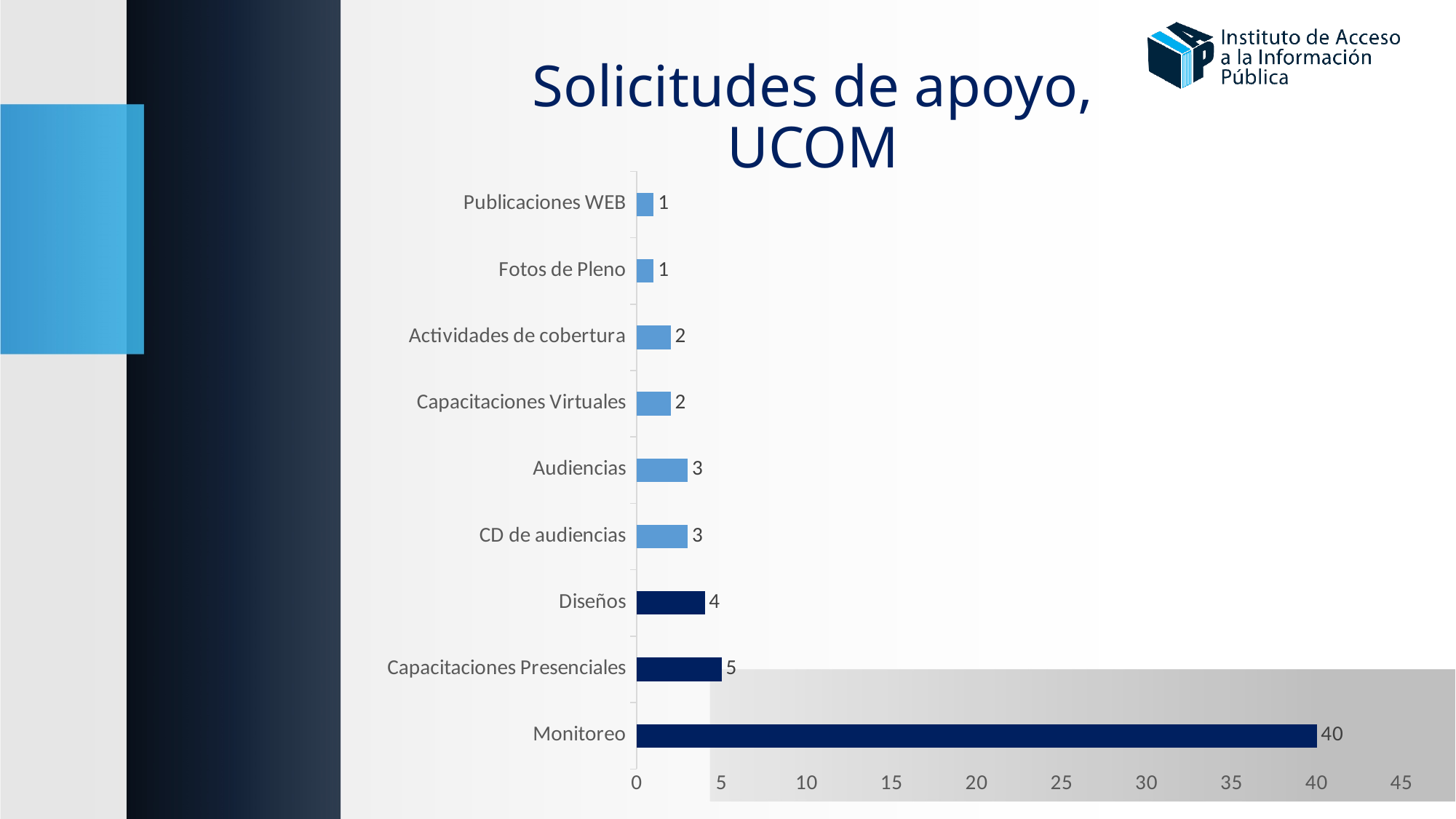
What is the difference between the values for Monitoreo and Capacitaciones Presenciales? 35 What is the highest value shown on the horizontal axis? 45 What kind of chart is shown on the slide? Bar chart What is the value for Monitoreo? 40 What is the value for Actividades de cobertura? 2 What is the title of the chart? Solicitudes de apoyo, UCOM Is the value for Monitoreo greater or less than 35? greater What is the value for Capacitaciones Presenciales? 5 How many categories are shown in the chart? 9 What is the value for Diseños? 4 Which is larger, the value for Diseños or the value for Audiencias? Diseños Which category has the highest value? Monitoreo